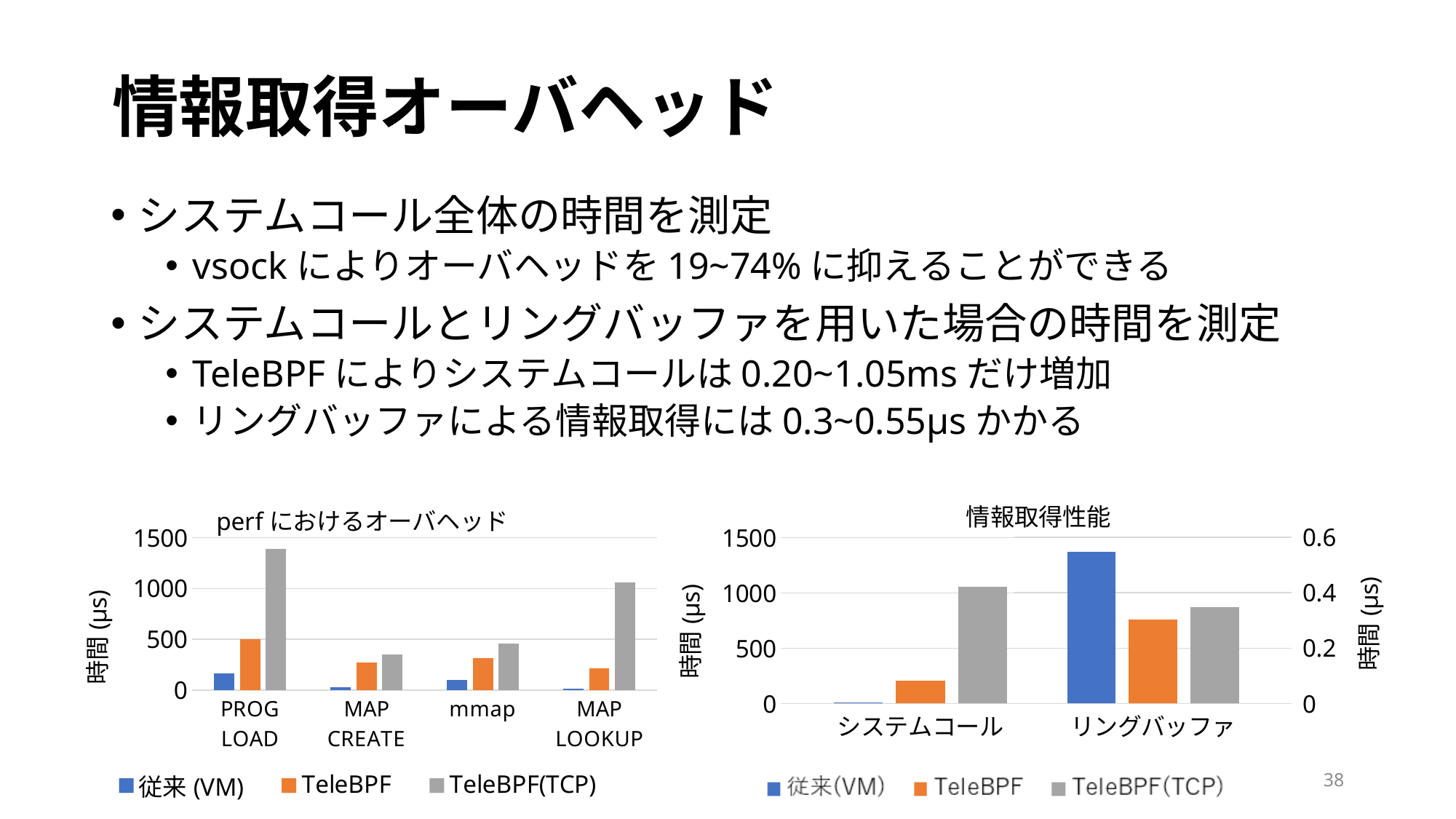
In the left chart 'perf におけるオーバヘッド', what is the label of the y axis? 時間 (µs) What kind of chart is the left chart titled 'perf におけるオーバヘッド'? bar chart In the left chart 'perf におけるオーバヘッド', which is larger for mmap: the TeleBPF value or the 従来 (VM) value? TeleBPF In the left chart 'perf におけるオーバヘッド', how many categories are shown on the x axis? 4 In the left chart 'perf におけるオーバヘッド', is the TeleBPF value for MAP CREATE greater or less than 500? less In the left chart 'perf におけるオーバヘッド', which category has the lowest TeleBPF(TCP) value? MAP CREATE In the right chart '情報取得性能', how many categories are shown on the x axis? 2 In the left chart 'perf におけるオーバヘッド', is the TeleBPF(TCP) value for PROG LOAD greater or less than 1000? greater In the right chart '情報取得性能', which series has the highest value for システムコール? TeleBPF(TCP) In the left chart 'perf におけるオーバヘッド', which category has the highest TeleBPF(TCP) value? PROG LOAD In the right chart '情報取得性能', is the TeleBPF value for システムコール greater or less than 500? less In the left chart 'perf におけるオーバヘッド', how many series does the legend list? 3